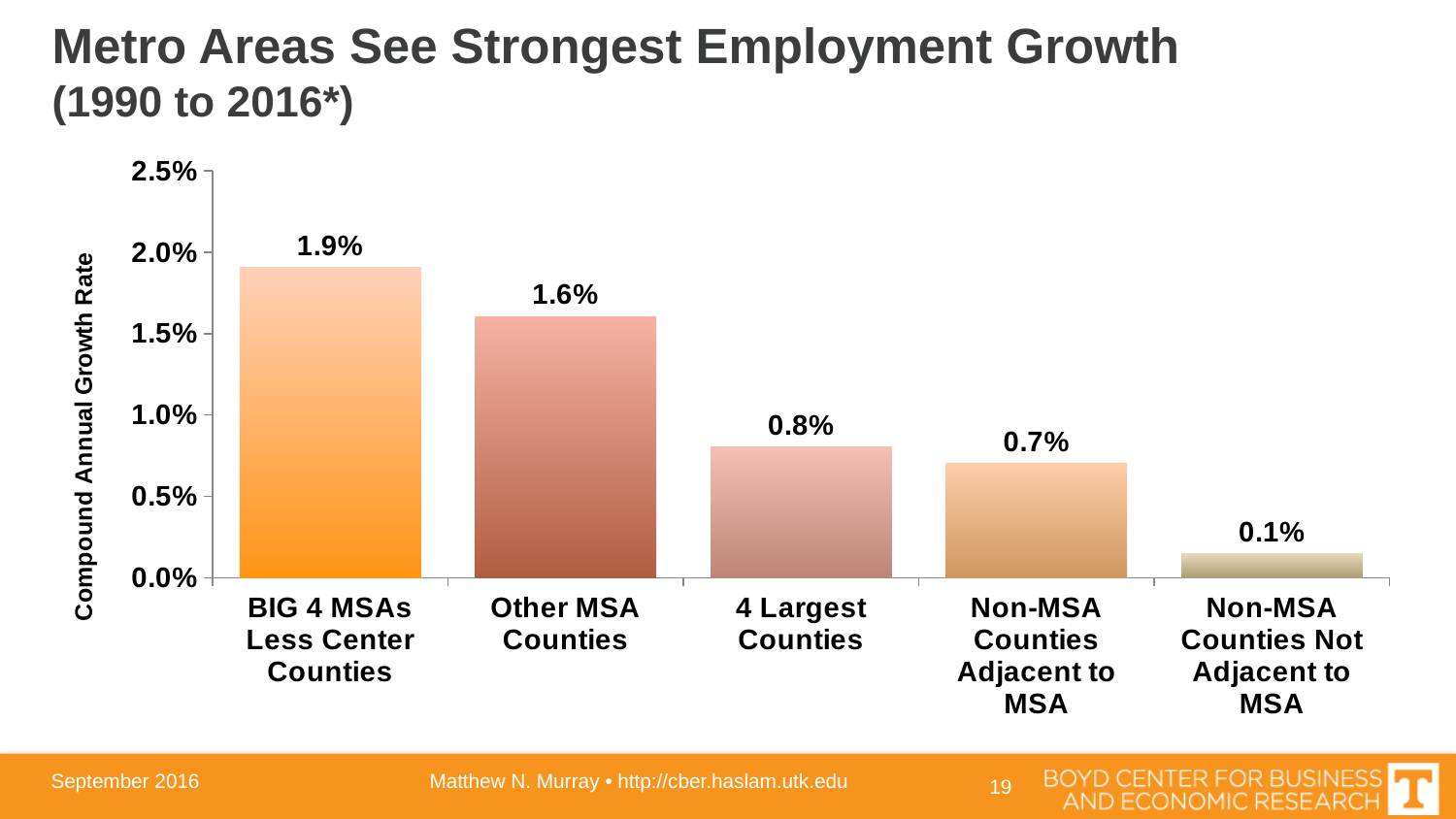
Do the values rise or fall moving from left to right across the categories? Fall What kind of chart is shown on the slide? Bar chart Which category has the lowest compound annual growth rate? Non-MSA Counties Not Adjacent to MSA What is the compound annual growth rate for Non-MSA Counties Not Adjacent to MSA? 0.1% What is the compound annual growth rate for BIG 4 MSAs Less Center Counties? 1.9% Which category has the highest compound annual growth rate? BIG 4 MSAs Less Center Counties Is the value for 4 Largest Counties greater or less than 1.0%? less What is the difference between the growth rates of BIG 4 MSAs Less Center Counties and 4 Largest Counties? 1.1% What is the label of the vertical axis? Compound Annual Growth Rate Which has a higher growth rate: Other MSA Counties or Non-MSA Counties Adjacent to MSA? Other MSA Counties How many categories are shown in the chart? 5 What is the compound annual growth rate for Other MSA Counties? 1.6%